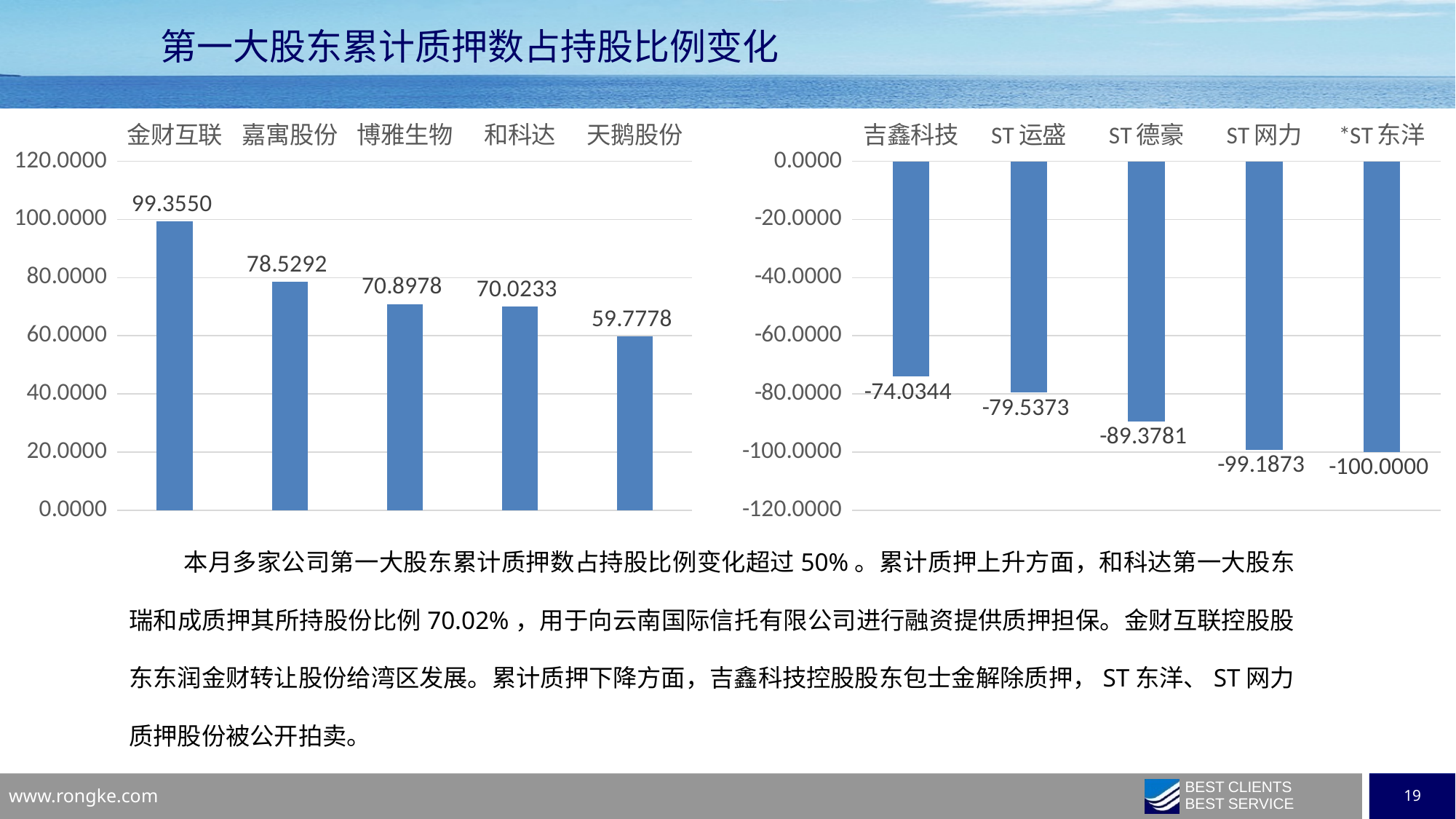
In the right chart, what is the difference between the values for 吉鑫科技 and ST运盛? 5.5029 In the left chart, what is the difference between the values for 金财互联 and 嘉寓股份? 20.8258 In the right chart, which category has the lowest value? *ST东洋 In the left chart, what is the value for 天鹅股份? 59.7778 In the left chart, which category has the highest value? 金财互联 In the right chart, what is the value for ST德豪? -89.3781 In the right chart, what is the value for *ST东洋? -100.0000 How many categories are shown in the right chart? 5 In the left chart, which is larger, the value for 博雅生物 or the value for 和科达? 博雅生物 In the right chart, do the values rise or fall from left to right along the x axis? fall In the left chart, what is the value for 金财互联? 99.3550 What kind of chart is the left chart? bar chart